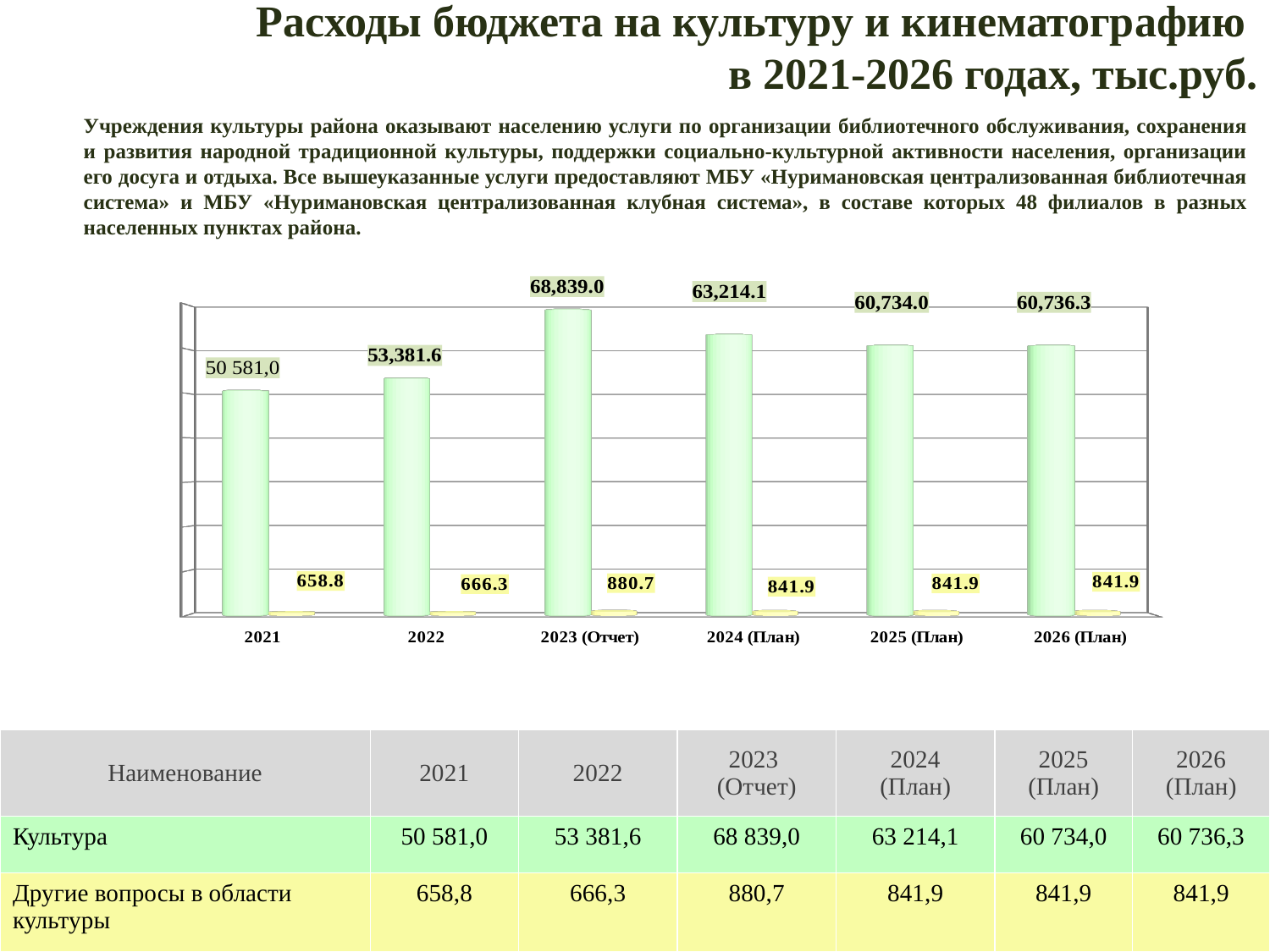
In which year is the Культура bar the highest? 2023 (Отчет) What is the value of the Другие вопросы в области культуры bar for 2023 (Отчет)? 880.7 What is the difference between the Другие вопросы в области культуры values for 2023 (Отчет) and 2024 (План)? 38.8 What kind of chart is shown on the slide? Bar chart In which year is the Другие вопросы в области культуры bar the lowest? 2021 How many year categories are shown on the x axis of the chart? 6 Which is larger, the Культура value for 2022 or for 2024 (План)? 2024 (План) What is the value of the Другие вопросы в области культуры bar for 2021? 658.8 What is the value of the Культура bar for 2023 (Отчет)? 68,839.0 What is the value of the Культура bar for 2021? 50 581,0 In which year is the Культура bar the lowest? 2021 What is the difference between the Культура values for 2023 (Отчет) and 2024 (План)? 5,624.9